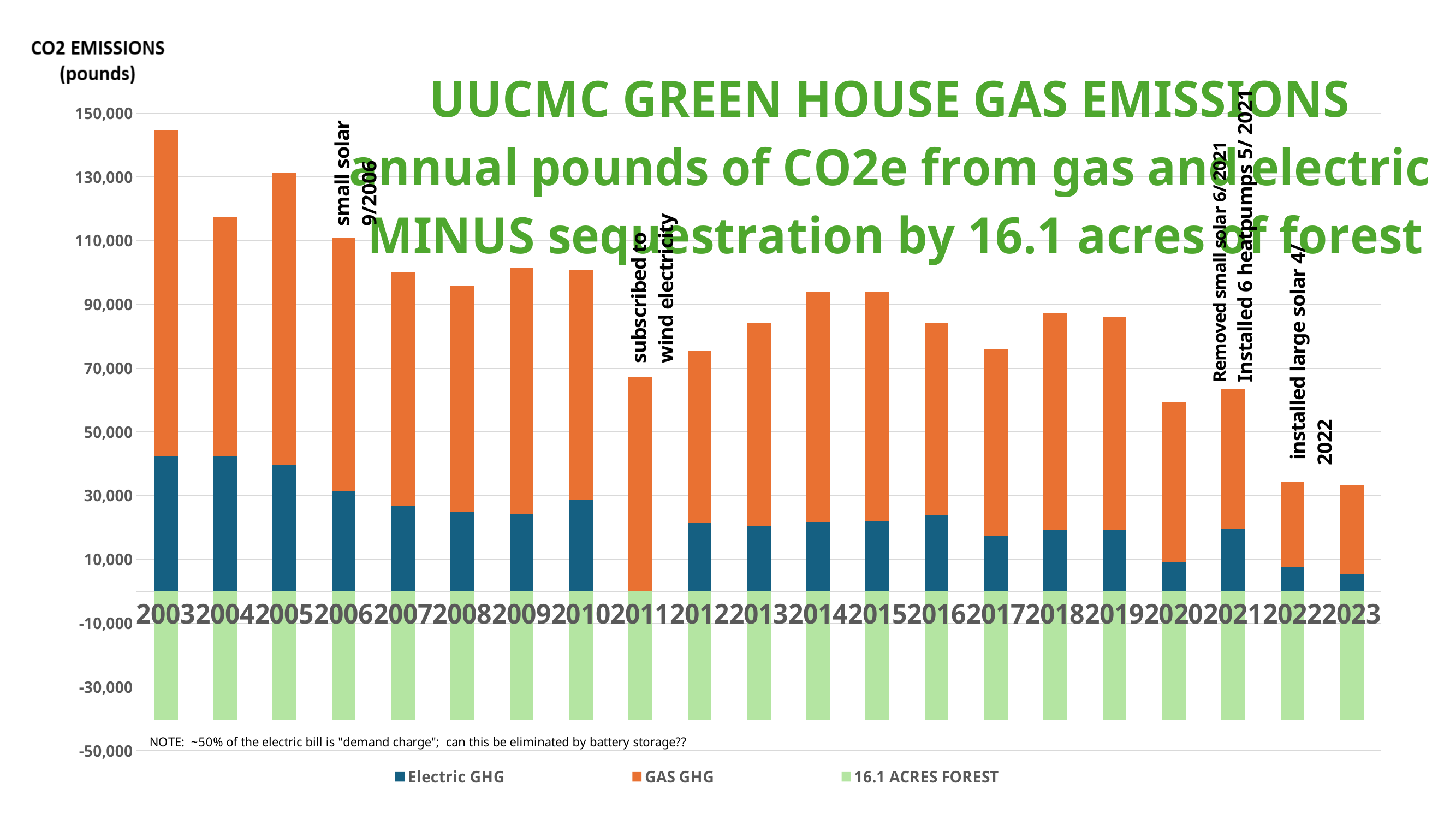
Is the Electric GHG value for 2011 greater or less than 10,000? less How many years are shown along the x axis of the chart? 21 Which year has the larger total positive emissions, 2003 or 2004? 2003 Is the total positive emissions bar for 2003 greater or less than 130,000? greater Do the total positive emissions generally rise or fall from 2003 to 2023? fall Is the total positive emissions bar for 2011 greater or less than 50,000? greater Which colour represents the GAS GHG series in the chart? orange Which year has the larger total positive emissions, 2014 or 2017? 2014 How many series does the chart legend list? 3 What kind of chart is shown on the slide? stacked bar chart Which year has the highest total positive emissions (Electric GHG plus GAS GHG)? 2003